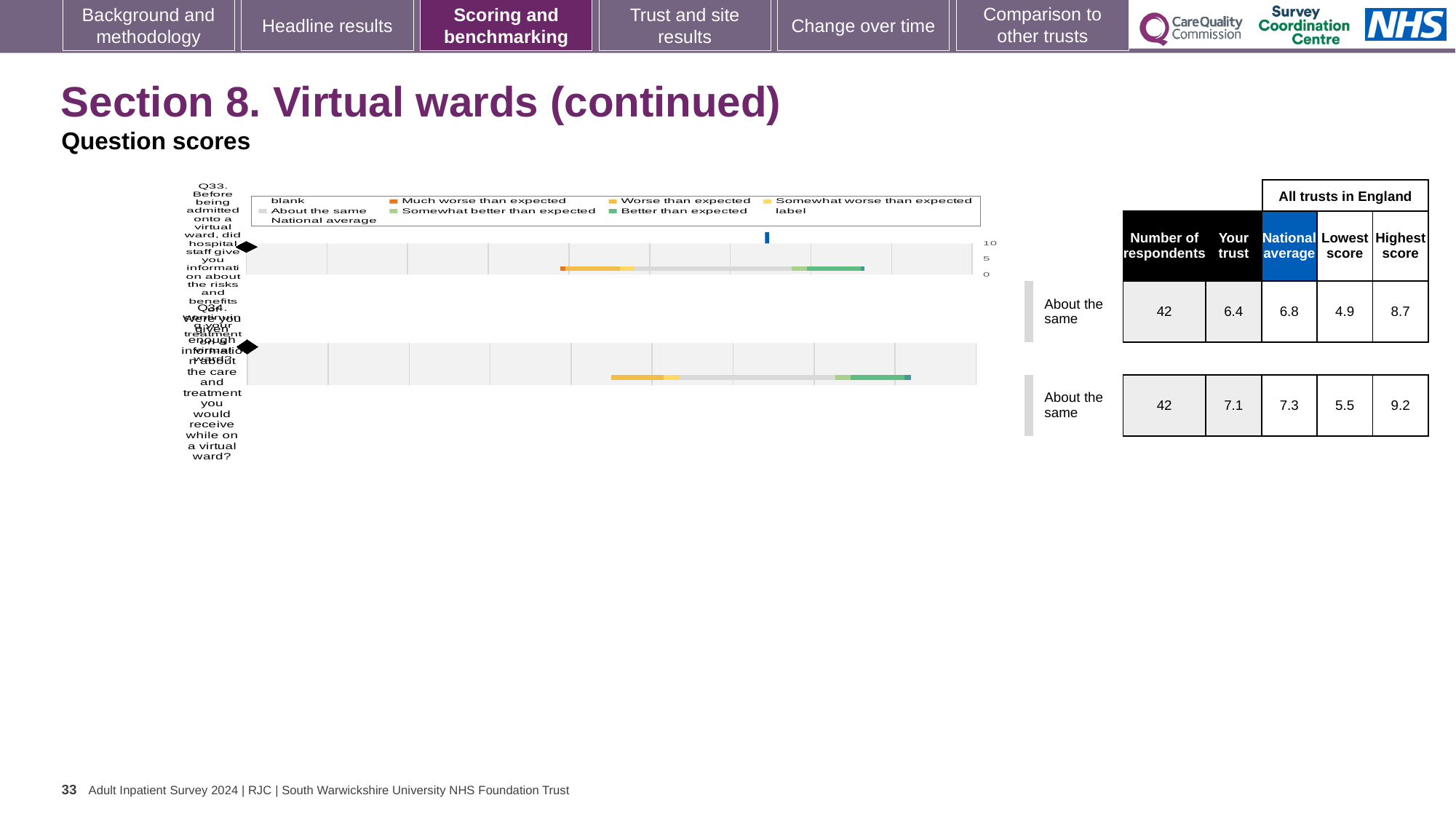
What kind of chart is used to show the question scores for Q33 and Q34? bar chart What is the 'Your trust' score for Q33 (information about the risks and benefits of a virtual ward)? 6.4 What is the national average score for Q34 (enough information about care and treatment on a virtual ward)? 7.3 How many respondents answered Q34? 42 What colour represents the 'Better than expected' band in the chart legend? green How many questions (categories) are shown in the question scores chart? 2 What is the highest score among all trusts in England for Q33? 8.7 What benchmark category is the trust placed in for Q33? About the same What is the difference between the highest and lowest scores for Q34 across all trusts in England? 3.7 What is the difference between the national average and the 'Your trust' score for Q33? 0.4 What is the lowest score among all trusts in England for Q34? 5.5 Which question has the higher 'Your trust' score, Q33 or Q34? Q34